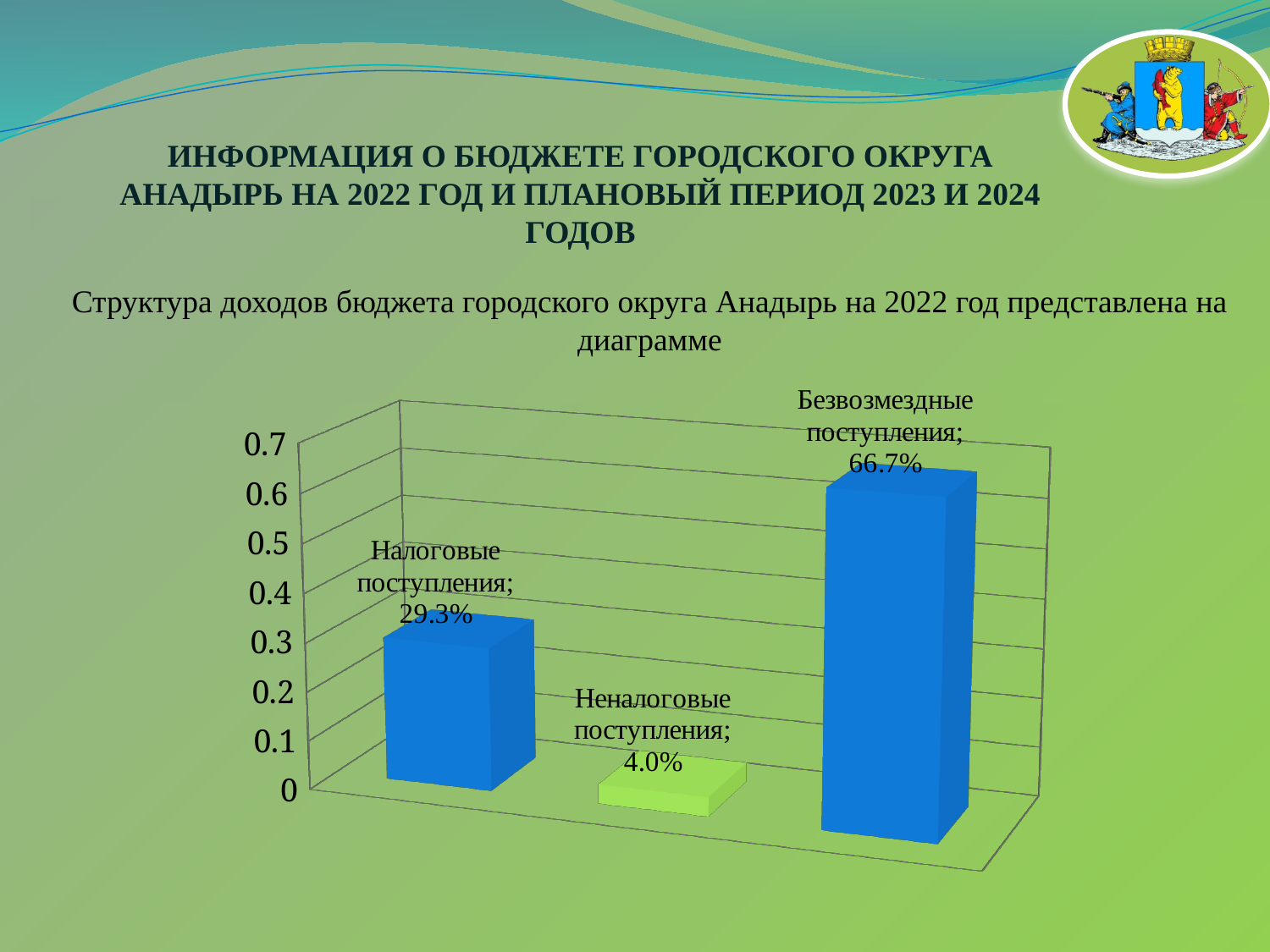
What is the value shown for Безвозмездные поступления? 66.7% What is the difference between Безвозмездные поступления and Налоговые поступления? 37.4% What is the difference between Налоговые поступления and Неналоговые поступления? 25.3% Which category has the highest value? Безвозмездные поступления Is the value for Неналоговые поступления greater or less than 0.1? less How many categories are shown in the chart? 3 Which is larger, Налоговые поступления or Неналоговые поступления? Налоговые поступления What is the value shown for Неналоговые поступления? 4.0% Is the value for Безвозмездные поступления greater or less than 0.5? greater Which category has the lowest value? Неналоговые поступления What kind of chart is shown on the slide? bar chart What is the value shown for Налоговые поступления? 29.3%